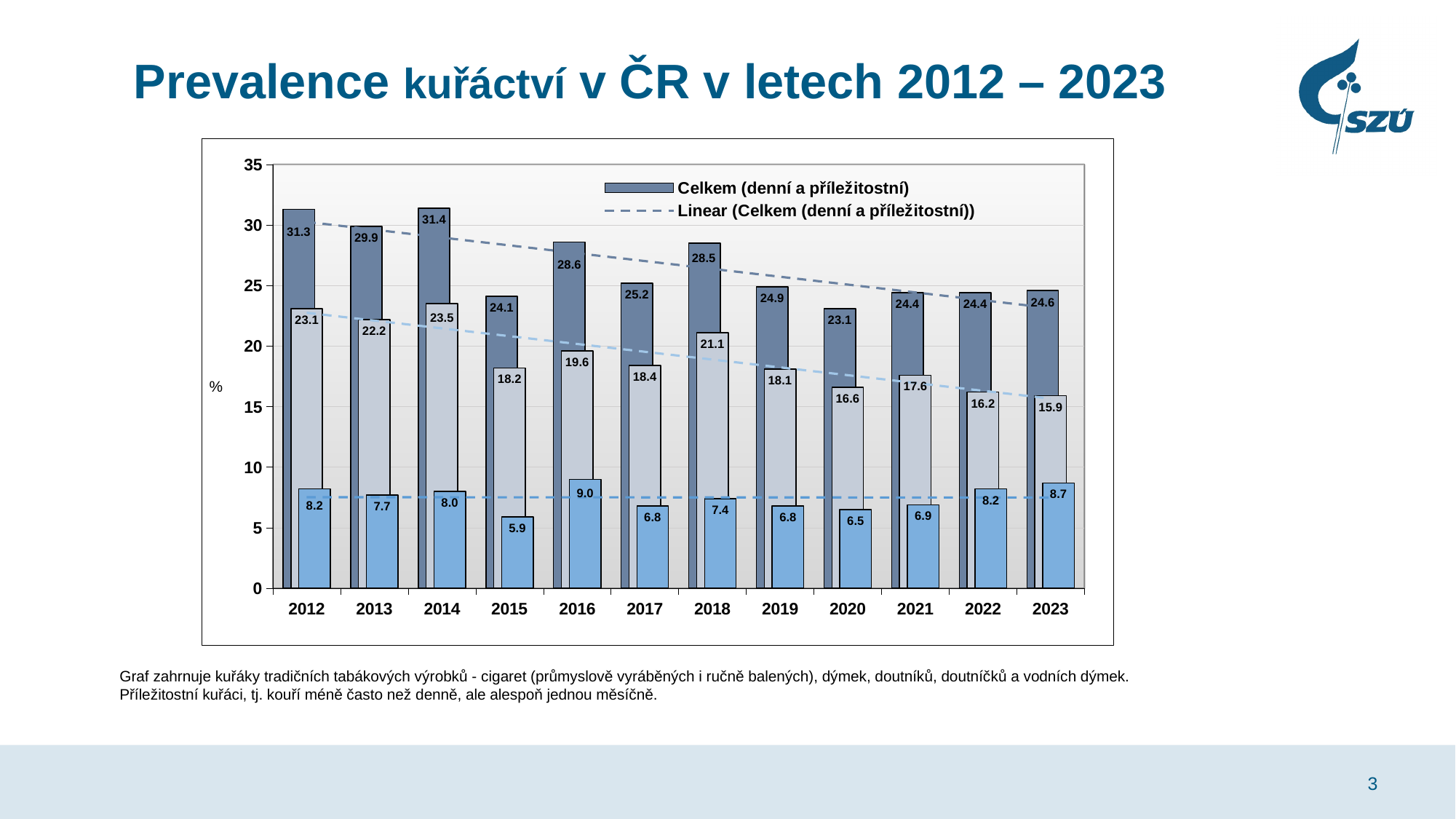
What kind of chart is shown on the slide? bar chart What is the value of Celkem (denní a příležitostní) for 2018? 28.5 What is the value of Celkem (denní a příležitostní) for 2012? 31.3 In which year is Celkem (denní a příležitostní) the highest? 2014 Is the Celkem (denní a příležitostní) value for 2020 greater or less than 25? less How many entries does the chart legend list? 2 Which year has the larger Celkem (denní a příležitostní) value, 2016 or 2017? 2016 How many years are shown on the x axis of the chart? 12 What is the value of Celkem (denní a příležitostní) for 2023? 24.6 In which year is Celkem (denní a příležitostní) the lowest? 2020 Does the Celkem (denní a příležitostní) series generally rise or fall from 2012 to 2023? fall What is the difference between the Celkem (denní a příležitostní) values for 2012 and 2023? 6.7